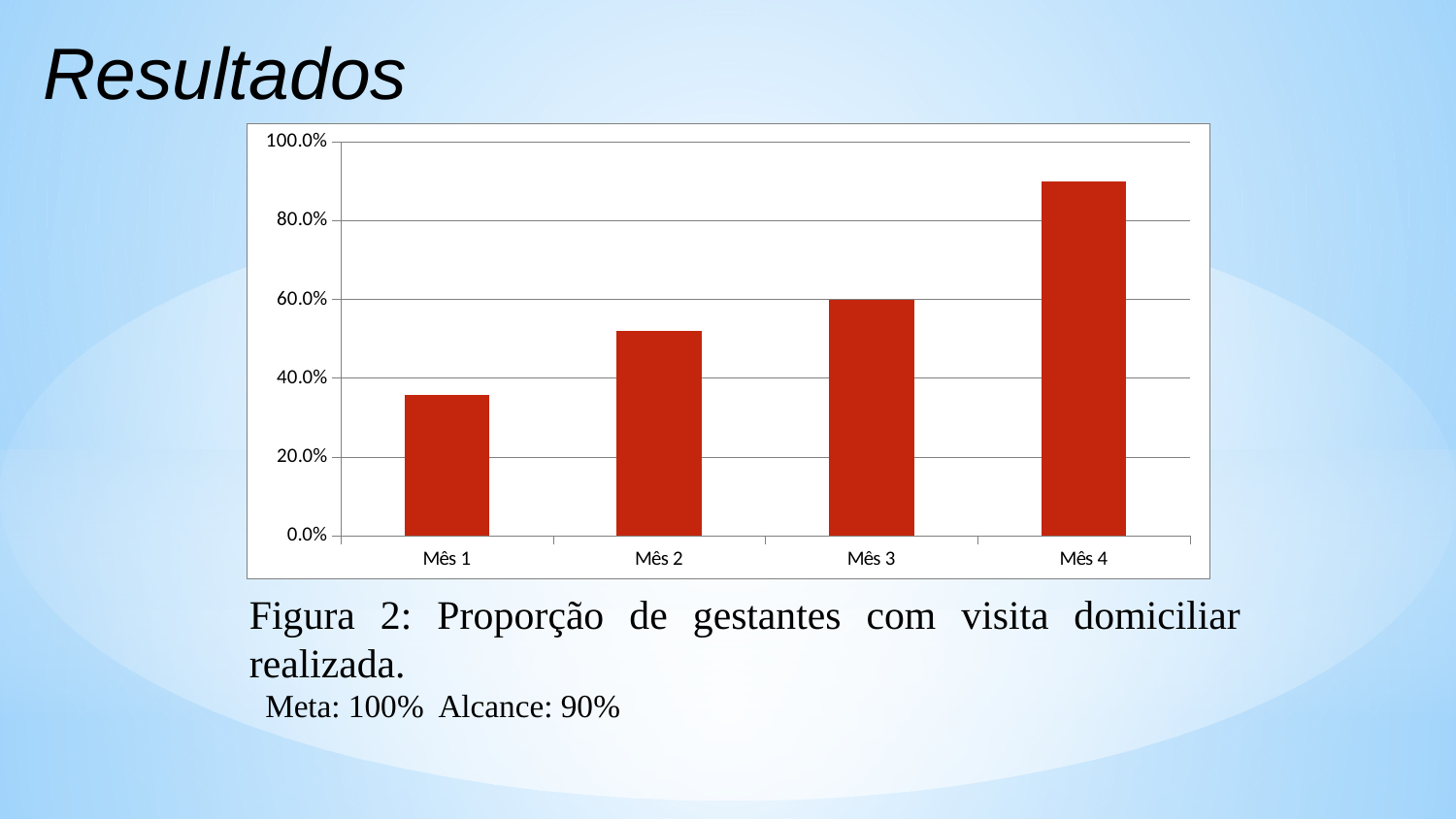
How many categories (months) are plotted on the x axis? 4 Which month has the highest bar? Mês 4 Do the values rise or fall from Mês 1 to Mês 4? Rise Is the value for Mês 1 greater or less than 40.0%? less Is the value for Mês 2 greater or less than 60.0%? less Which is larger, the value for Mês 2 or the value for Mês 3? Mês 3 Is the value for Mês 2 greater or less than 40.0%? greater What kind of chart is shown on the slide? Bar chart Which month has the lowest bar? Mês 1 What is the figure caption given below the chart? Figura 2: Proporção de gestantes com visita domiciliar realizada. What is the highest value shown on the y axis? 100.0%